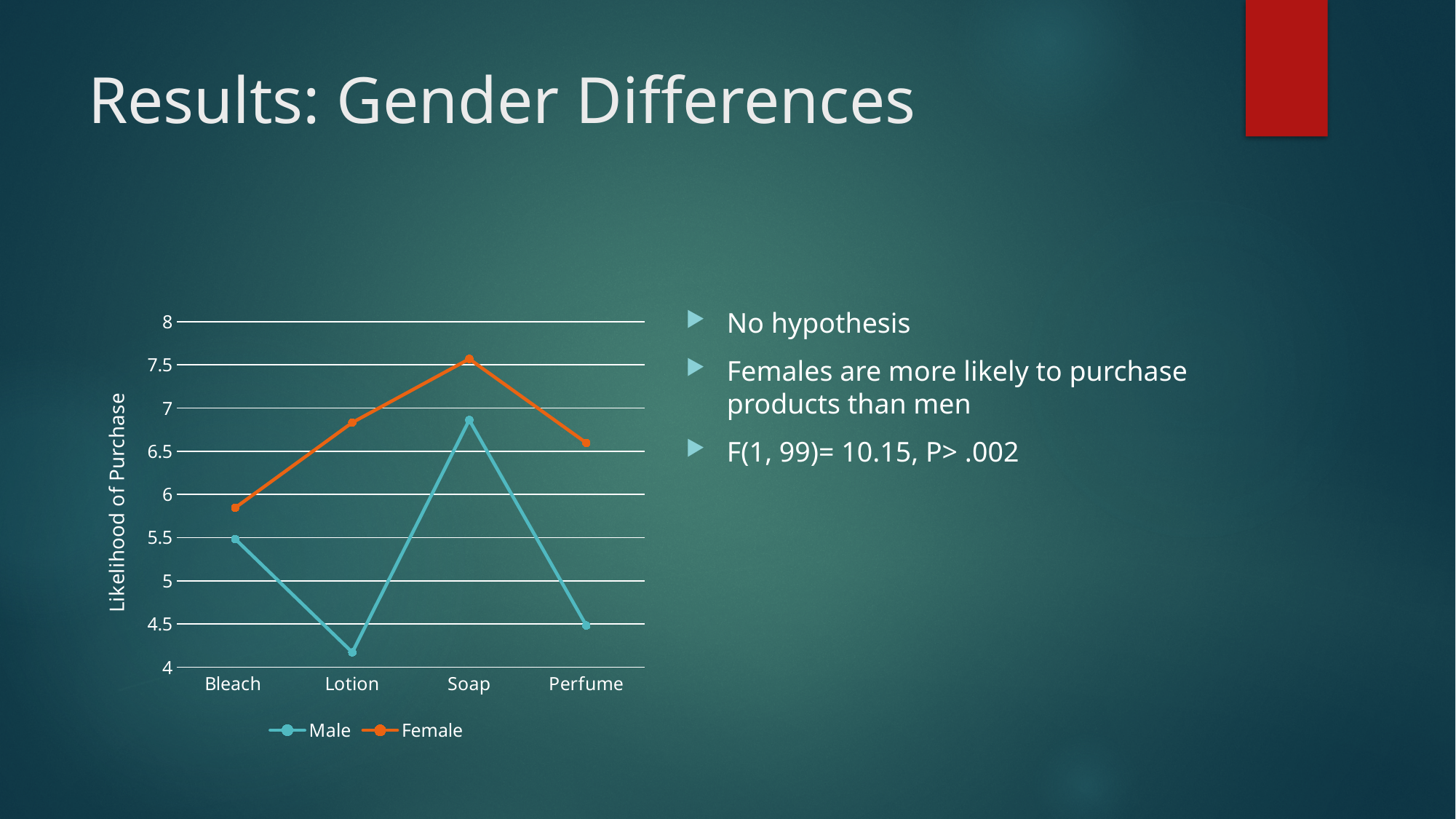
Is the Male value for Perfume greater or less than 5? less Is the Female value for Soap greater or less than 7? greater How many series does the chart's legend list? 2 How many product categories are shown on the x axis of the chart? 4 For which product is the Male series lowest? Lotion What kind of chart is shown on the slide? line chart For which product is the Female series lowest? Bleach Is the Male value for Lotion greater or less than 4.5? less For which product is the Female series highest? Soap What is the title of the chart's vertical axis? Likelihood of Purchase For which product is the Male series highest? Soap For Lotion, which series has the larger value, Male or Female? Female